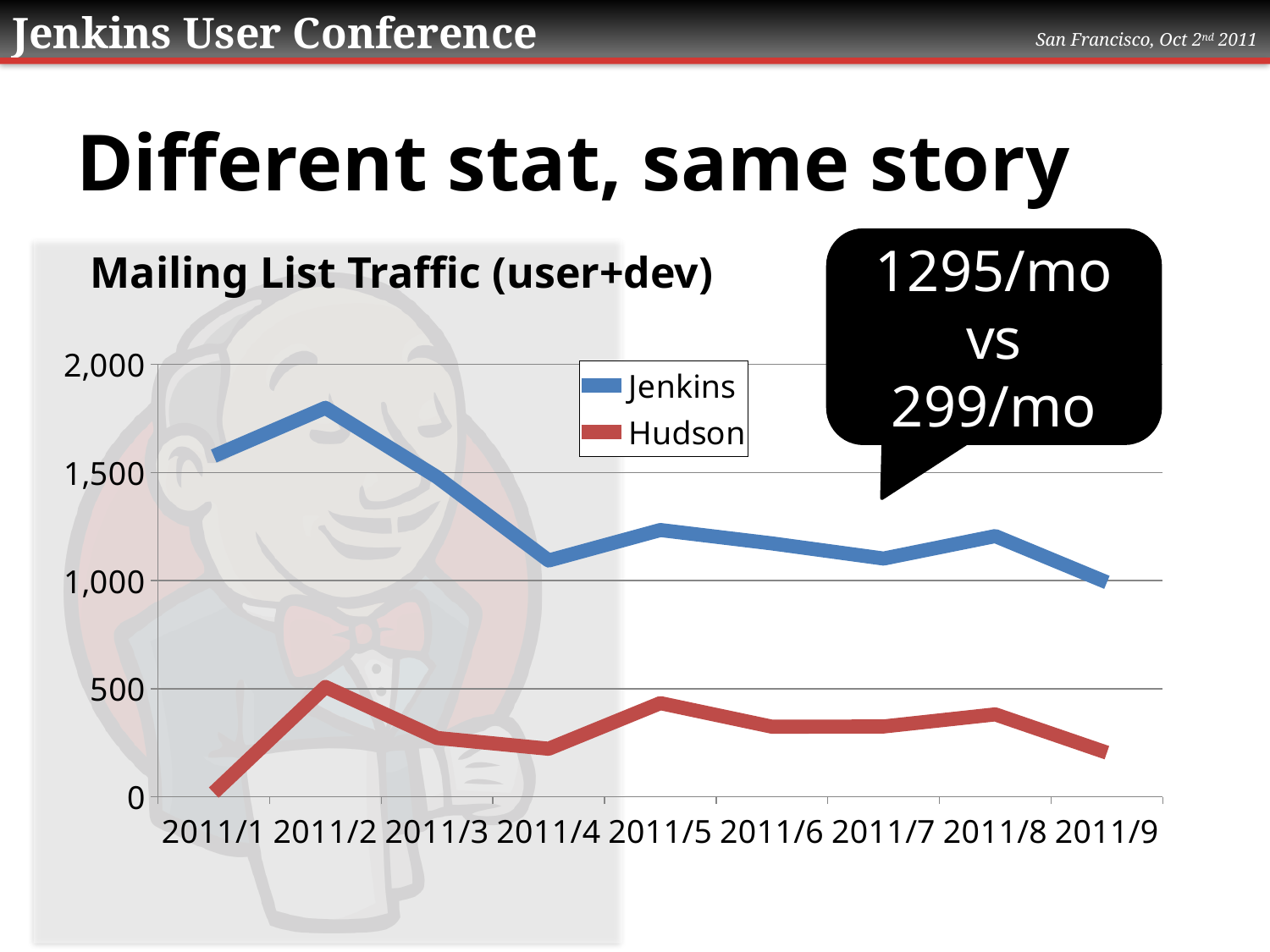
What is the title of the chart? Mailing List Traffic (user+dev) What kind of chart is shown on the slide? line chart Which series has the larger value in 2011/6, Jenkins or Hudson? Jenkins How many months are plotted along the x axis? 9 Does the Jenkins series overall rise or fall from 2011/2 to 2011/9? fall Is the Hudson value for 2011/5 greater or less than 500? less How many series does the legend list? 2 In which month does the Hudson series have its lowest value? 2011/1 Which colour is used for the Hudson series? red Is the Jenkins value for 2011/2 greater or less than 1,500? greater In which month does the Jenkins series reach its highest value? 2011/2 Is the Hudson value for 2011/9 greater or less than 500? less